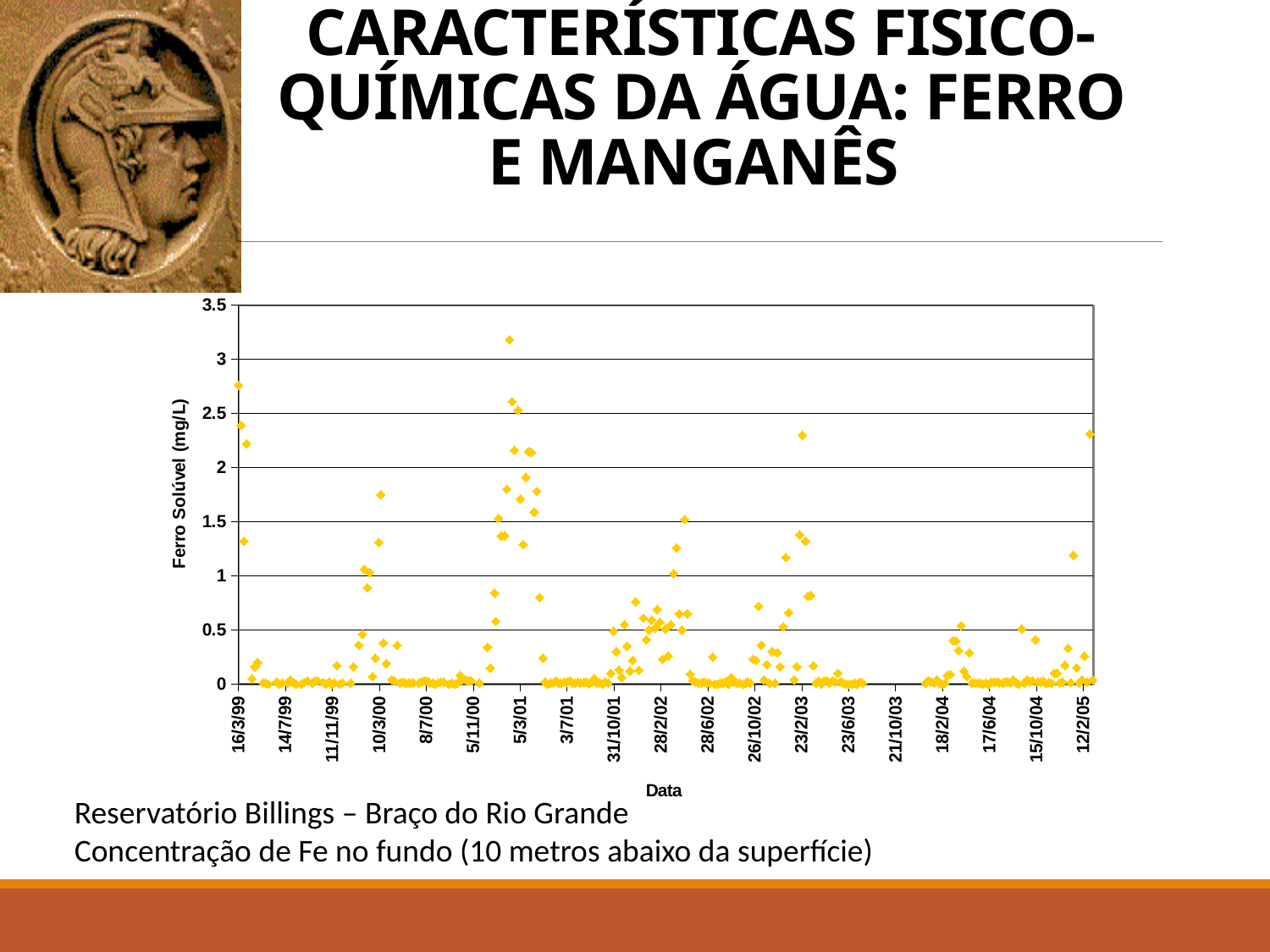
What is the label of the x-axis of the chart? Data Is the first plotted value at 16/3/99 greater or less than 2.5? greater Is the highest plotted value on the chart greater or less than 3.5? less Is the highest plotted value on the chart greater or less than 3? greater How many date labels are shown on the x-axis of the chart? 19 What kind of chart is shown on the slide? scatter plot Near which x-axis date label does the highest plotted value occur? 5/3/01 What is the maximum value shown on the y-axis of the chart? 3.5 What is the label of the y-axis of the chart? Ferro Solúvel (mg/L)